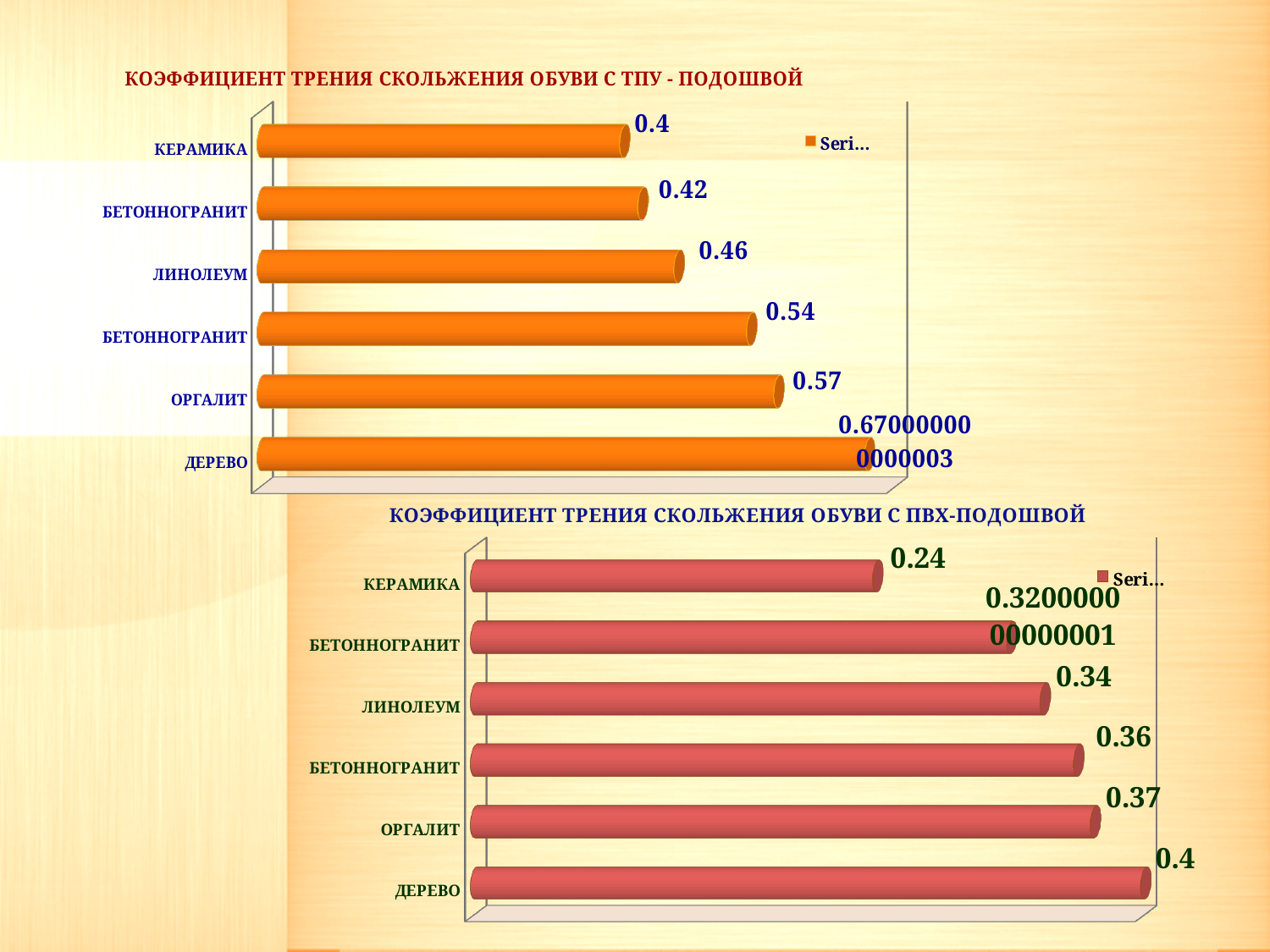
How many bars does the bottom chart (ПВХ-подошва) have? 6 In the bottom chart (ПВХ-подошва), what is the value for КЕРАМИКА? 0.24 What type of chart is the top chart (ТПУ-подошва)? bar chart In the bottom chart (ПВХ-подошва), what is the value for ДЕРЕВО? 0.4 In the top chart (ТПУ-подошва), what is the value for ОРГАЛИТ? 0.57 In the top chart (ТПУ-подошва), what is the value for ЛИНОЛЕУМ? 0.46 In the top chart (ТПУ-подошва), what is the value for КЕРАМИКА? 0.4 In the top chart (ТПУ-подошва), which category has the highest value? ДЕРЕВО In the top chart (ТПУ-подошва), which category has the lowest value? КЕРАМИКА In the bottom chart (ПВХ-подошва), which is larger, the value for ОРГАЛИТ or the value for ЛИНОЛЕУМ? ОРГАЛИТ In the top chart (ТПУ-подошва), what is the difference between the values for ОРГАЛИТ and ЛИНОЛЕУМ? 0.11 Which is larger, the value for ОРГАЛИТ in the top chart (ТПУ-подошва) or the value for ОРГАЛИТ in the bottom chart (ПВХ-подошва)? top chart (ТПУ-подошва)